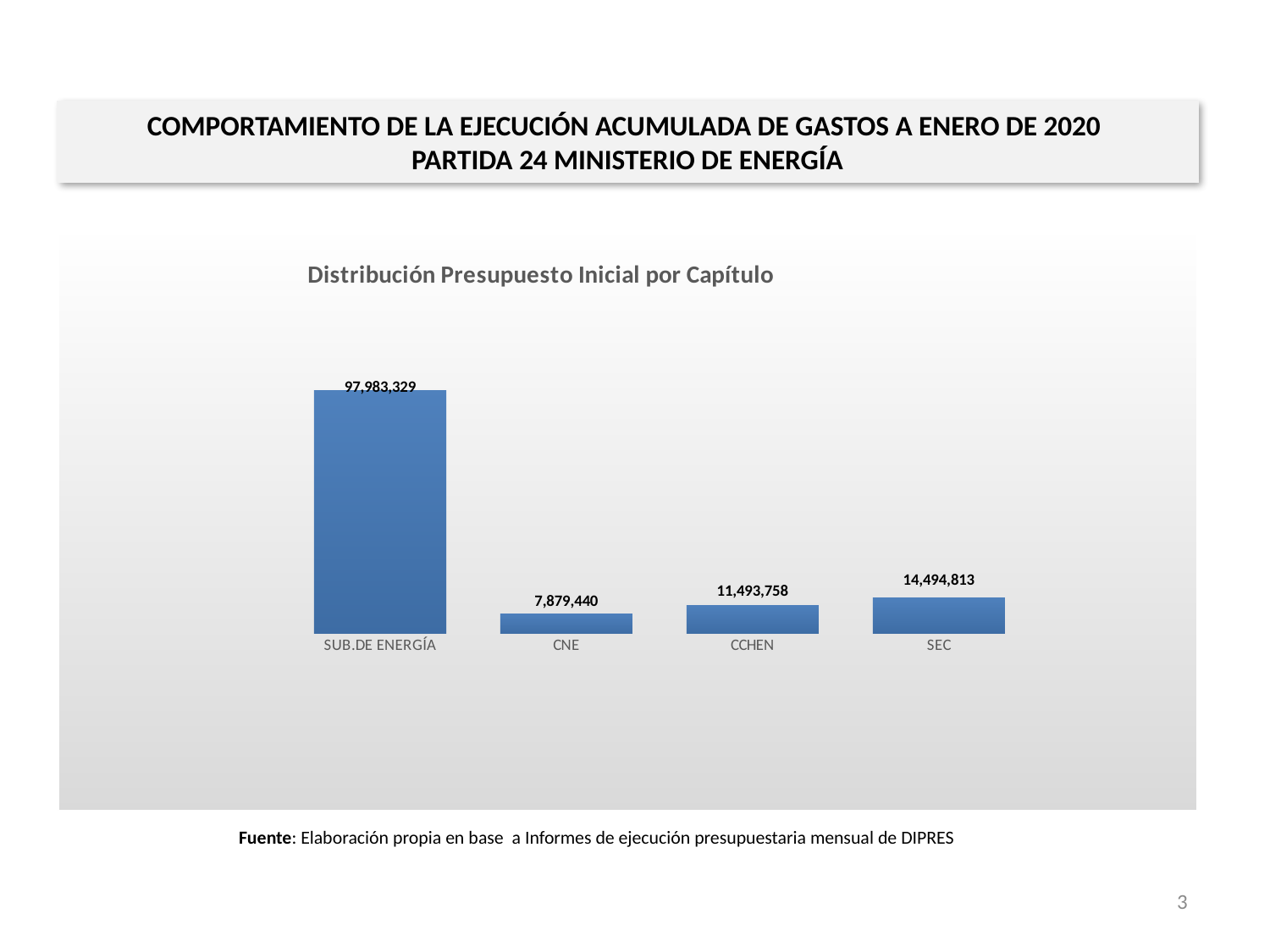
What is the value for CNE? 7,879,440 What is the value for SUB.DE ENERGÍA? 97,983,329 What is the value for CCHEN? 11,493,758 Which category has the highest value? SUB.DE ENERGÍA What is the title of the chart? Distribución Presupuesto Inicial por Capítulo Which category has the lowest value? CNE Which is larger, the value for CCHEN or the value for SEC? SEC What is the difference between the values for SUB.DE ENERGÍA and CNE? 90,103,889 What kind of chart is shown on the slide? Bar chart What is the value for SEC? 14,494,813 How many categories are shown in the chart? 4 What is the difference between the values for SEC and CCHEN? 3,001,055